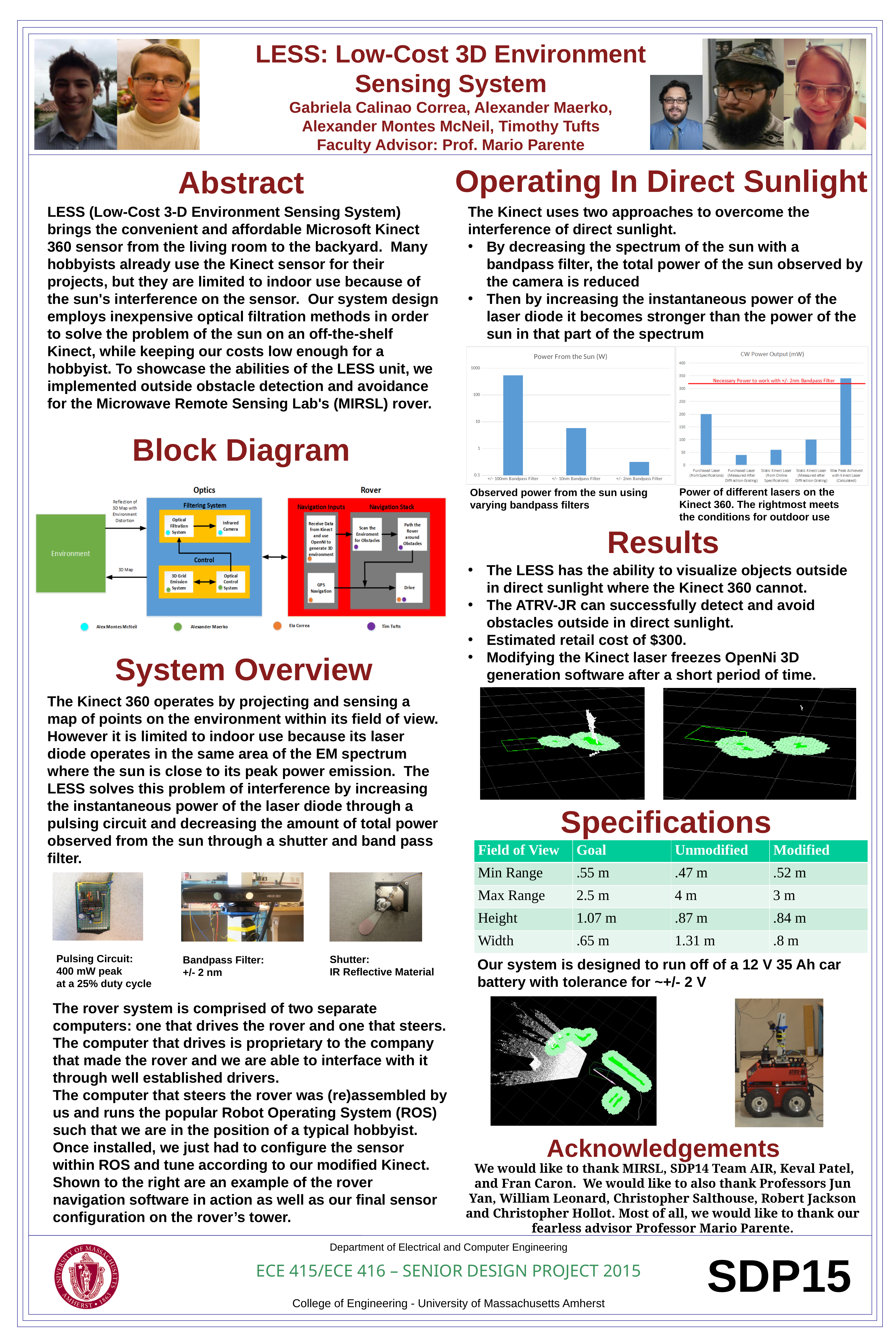
In the "CW Power Output (mW)" chart, which category has the highest value? Max Peak Achieved with Kinect Laser (Calculated) In the "CW Power Output (mW)" chart, which category has the lowest value? Purchased Laser (Measured After Diffraction Grating) In the "CW Power Output (mW)" chart, is the value for Max Peak Achieved with Kinect Laser (Calculated) greater or less than 300? greater In the "Power From the Sun (W)" chart, is the value for the +/- 2nm Bandpass Filter greater or less than 1? less In the "Power From the Sun (W)" chart, do the values rise or fall from left to right across the categories? fall In the "Power From the Sun (W)" chart, which bandpass filter gives the lowest observed power? +/- 2nm Bandpass Filter How many bandpass filter categories are shown in the "Power From the Sun (W)" chart? 3 In the "Power From the Sun (W)" chart, is the value for the +/- 100nm Bandpass Filter greater or less than 100? greater How many categories are shown in the "CW Power Output (mW)" chart? 5 In the "Power From the Sun (W)" chart, which bandpass filter gives the highest observed power? +/- 100nm Bandpass Filter What kind of chart is the "Power From the Sun (W)" chart? bar chart In the "CW Power Output (mW)" chart, what does the red horizontal line represent? Necessary Power to work with +/- 2nm Bandpass Filter